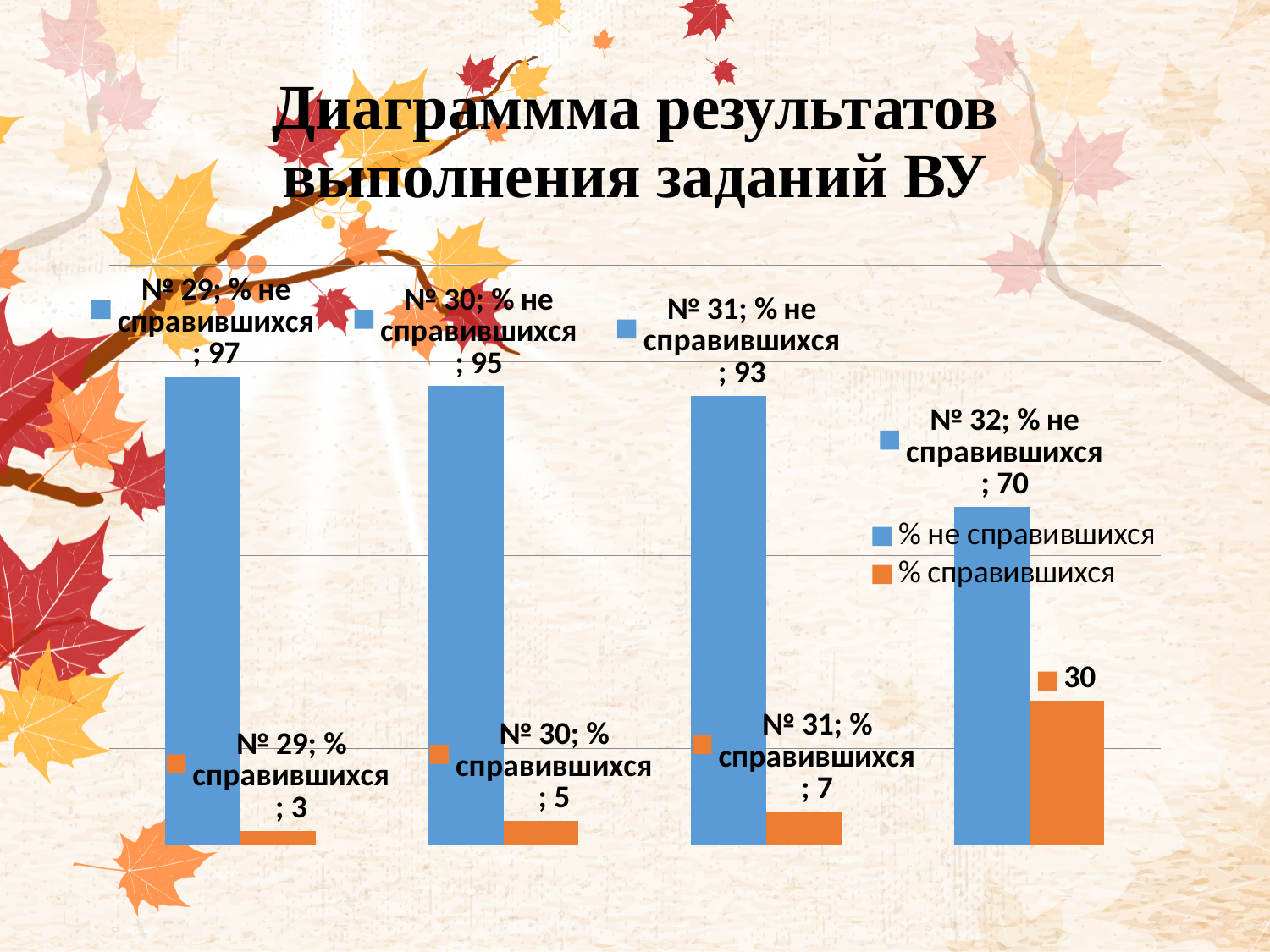
How many series does the legend list? 2 What is the value of "% справившихся" for № 30? 5 Which task number has the highest value of "% справившихся"? № 32 What is the value of "% не справившихся" for № 31? 93 Which is larger: "% справившихся" for № 31 or for № 30? № 31 Do the values of "% не справившихся" rise or fall from № 29 to № 32? Fall How many task numbers (categories) are shown in the chart? 4 Which task number has the lowest value of "% не справившихся"? № 32 What is the value of "% не справившихся" for № 29? 97 What kind of chart is shown on the slide? Bar chart What is the value of "% справившихся" for № 32? 30 What is the difference between "% не справившихся" for № 29 and for № 32? 27